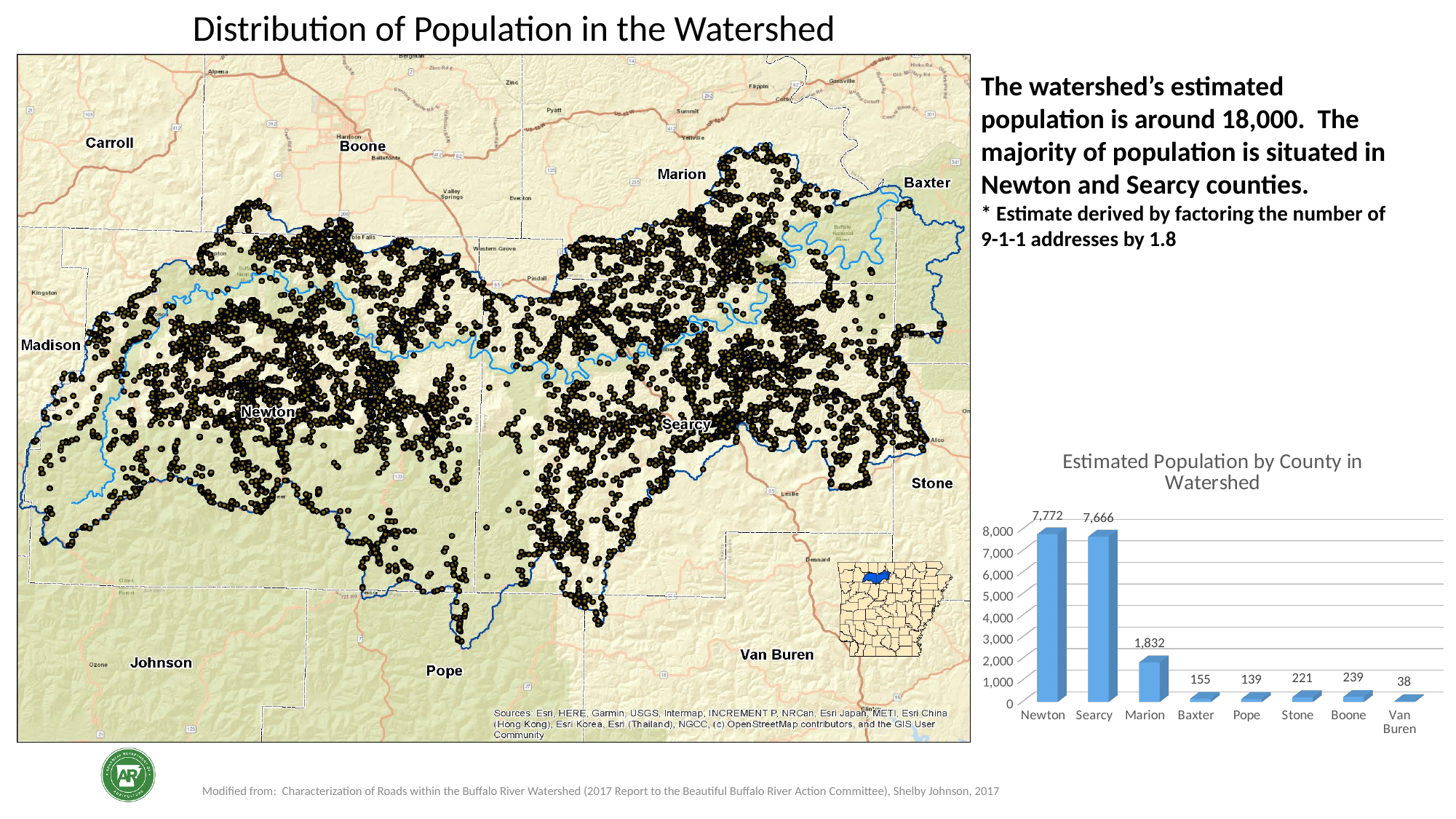
What is the estimated population for Marion county in the chart? 1,832 What is the estimated population for Newton county in the chart? 7,772 What is the title of the chart on the slide? Estimated Population by County in Watershed Which has a larger estimated population, Stone or Baxter? Stone What is the difference between the estimated populations of Newton and Searcy counties? 106 What kind of chart is used to show estimated population by county? Bar chart Is the value for Marion greater or less than 1,000? greater Which county has the highest estimated population in the chart? Newton What is the estimated population for Van Buren county in the chart? 38 What is the difference between the estimated populations of Boone and Pope counties? 100 Which county has the lowest estimated population in the chart? Van Buren How many counties are shown in the chart? 8